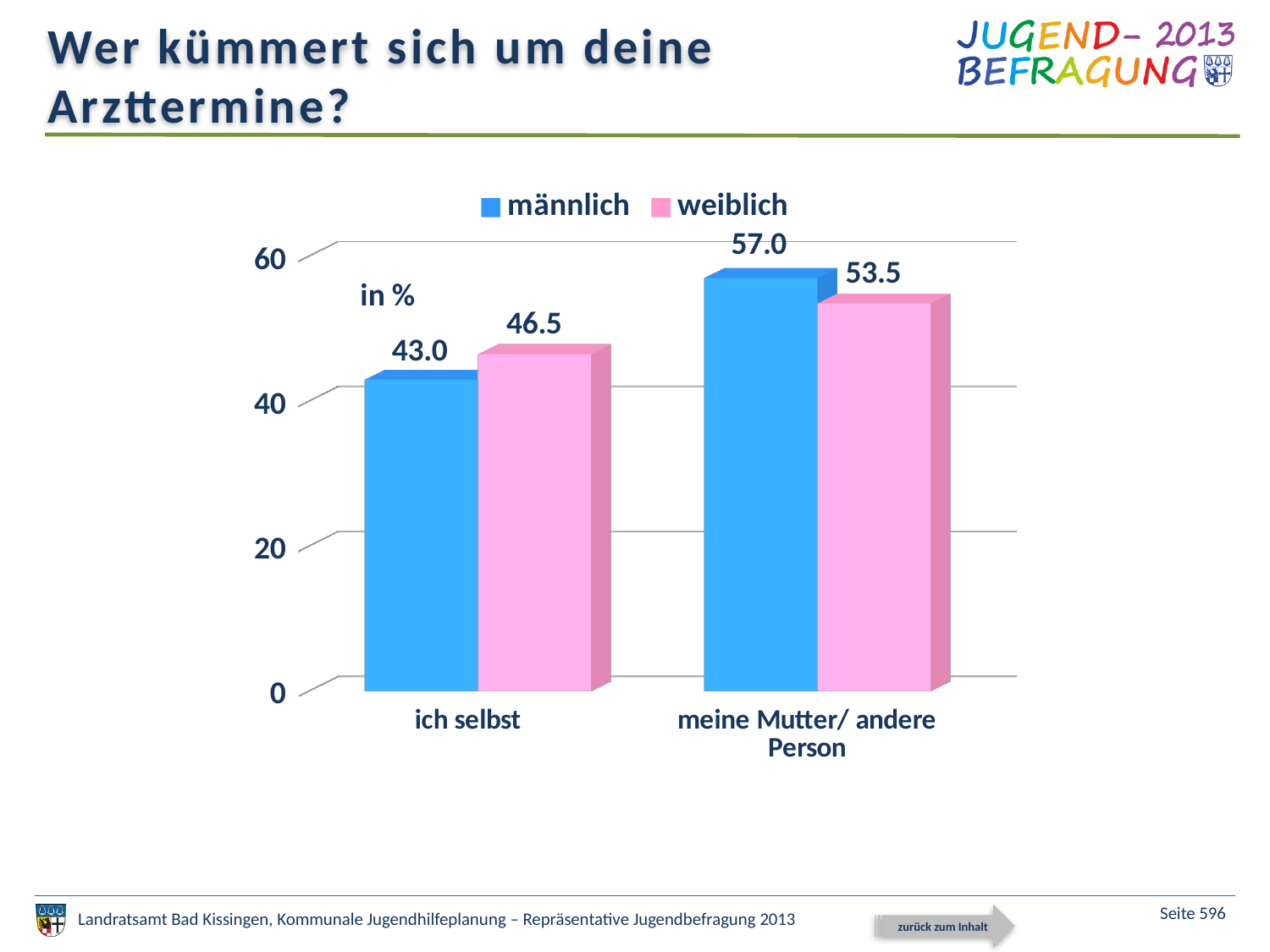
How many categories are shown on the x axis? 2 Which category has the highest value for männlich? meine Mutter/ andere Person What is the difference between the männlich and weiblich values for 'ich selbst'? 3.5 What is the value for weiblich in the category 'meine Mutter/ andere Person'? 53.5 What is the value for männlich in the category 'ich selbst'? 43.0 What is the difference between the männlich and weiblich values for 'meine Mutter/ andere Person'? 3.5 What is the value for weiblich in the category 'ich selbst'? 46.5 Which category has the lowest value for weiblich? ich selbst How many series does the legend list? 2 What kind of chart is shown on the slide? bar chart For 'ich selbst', which is larger: the männlich value or the weiblich value? weiblich What is the value for männlich in the category 'meine Mutter/ andere Person'? 57.0